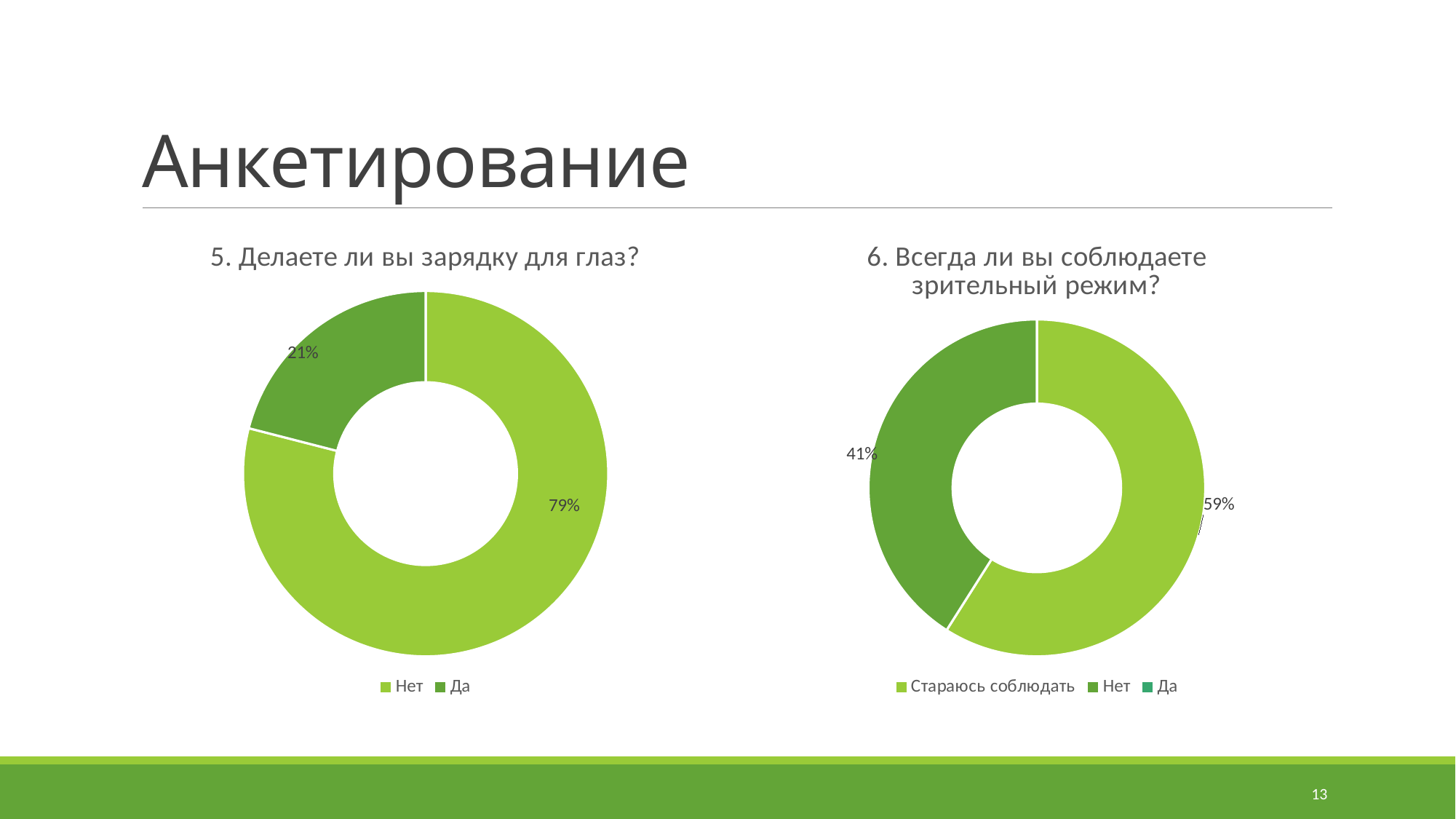
How many entries does the legend of the chart "6. Всегда ли вы соблюдаете зрительный режим?" list? 3 In the chart "6. Всегда ли вы соблюдаете зрительный режим?", what percentage is shown for "Нет"? 41% In the chart "5. Делаете ли вы зарядку для глаз?", what is the difference in percentage points between "Нет" and "Да"? 58 What is the title of the chart on the right side of the slide? 6. Всегда ли вы соблюдаете зрительный режим? What type of chart is used for "5. Делаете ли вы зарядку для глаз?"? Doughnut chart How many entries does the legend of the chart "5. Делаете ли вы зарядку для глаз?" list? 2 In the chart "5. Делаете ли вы зарядку для глаз?", what percentage is shown for "Да"? 21% In the chart "5. Делаете ли вы зарядку для глаз?", which answer has the largest share? Нет In the chart "6. Всегда ли вы соблюдаете зрительный режим?", what is the difference in percentage points between "Стараюсь соблюдать" and "Нет"? 18 In the chart "6. Всегда ли вы соблюдаете зрительный режим?", which is larger, "Стараюсь соблюдать" or "Нет"? Стараюсь соблюдать In the chart "5. Делаете ли вы зарядку для глаз?", what percentage is shown for "Нет"? 79% In the chart "6. Всегда ли вы соблюдаете зрительный режим?", what percentage is shown for "Стараюсь соблюдать"? 59%